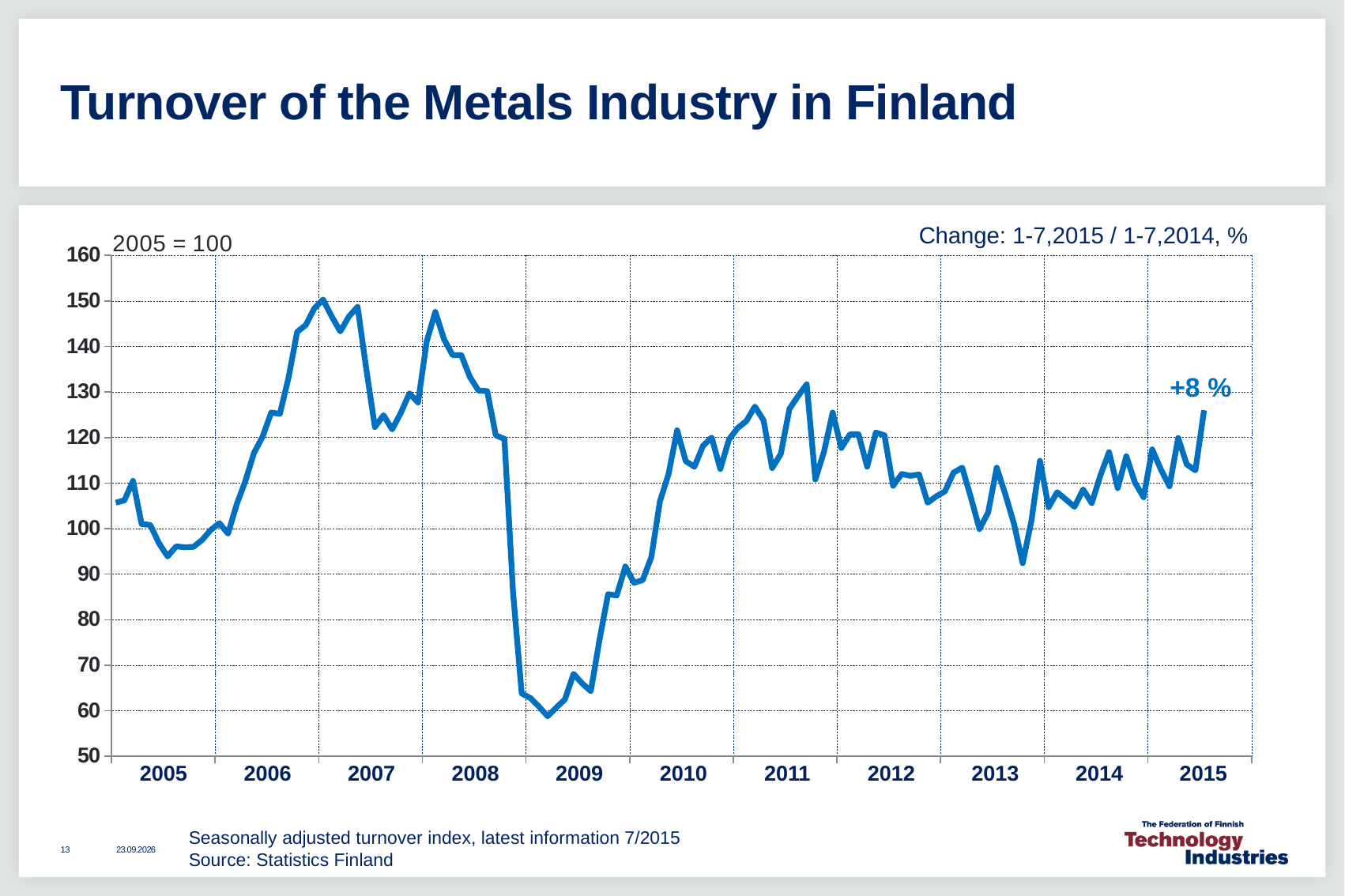
What is the title of the chart on the slide? Turnover of the Metals Industry in Finland Is the peak value of the index in 2006 greater or less than 140? greater In which year does the index reach its lowest point? 2009 What percentage change for 1-7,2015 / 1-7,2014 is printed on the chart? +8 % How many year labels are shown on the x axis? 11 Is the last plotted value in 2015 greater or less than 120? greater Is the index value at the start of 2005 greater or less than 120? less What kind of chart is shown on the slide? line chart Which is higher, the index peak in 2006 or the index peak in 2011? 2006 What is the base year of the index, as noted at the top left of the chart? 2005 = 100 Does the index rise or fall between the start of 2008 and the end of 2008? fall